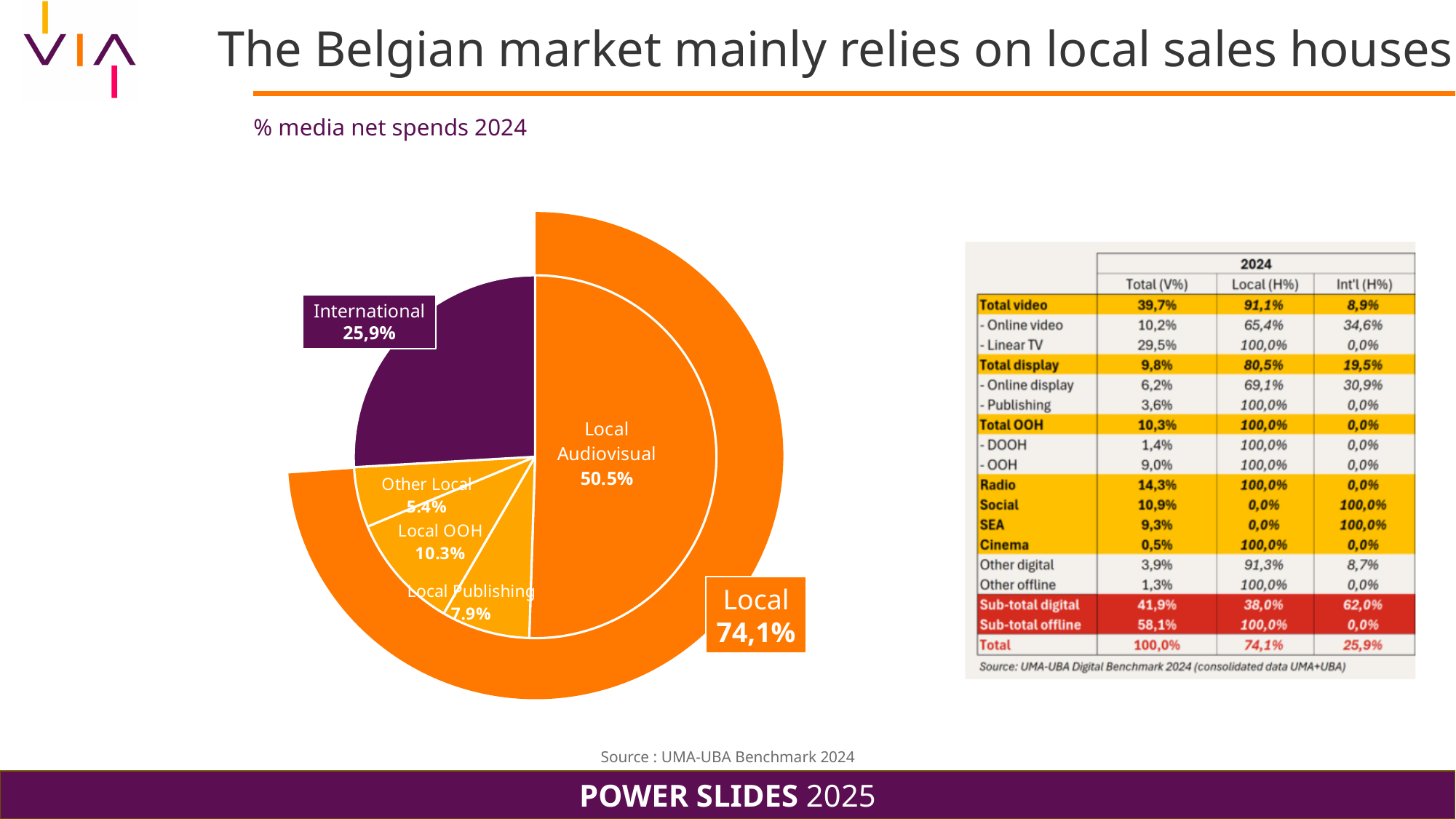
What is the value shown for Other Local in the pie chart? 5.4% Which slice of the pie chart is the largest? Local Audiovisual What is the value shown for International in the pie chart? 25,9% What is the difference between the Local Audiovisual share and the International share in the pie chart? 24.6 percentage points Which slice of the pie chart is the smallest? Other Local What is the value shown for Local Publishing in the pie chart? 7.9% What is the value shown for Local OOH in the pie chart? 10.3% What share of media net spend does Local Audiovisual account for in the pie chart? 50.5% Which is larger in the pie chart, Local OOH or Local Publishing? Local OOH How many slices does the pie chart have? 5 What total share is shown for Local in the outer ring of the pie chart? 74,1% What kind of chart is shown on the slide? pie chart